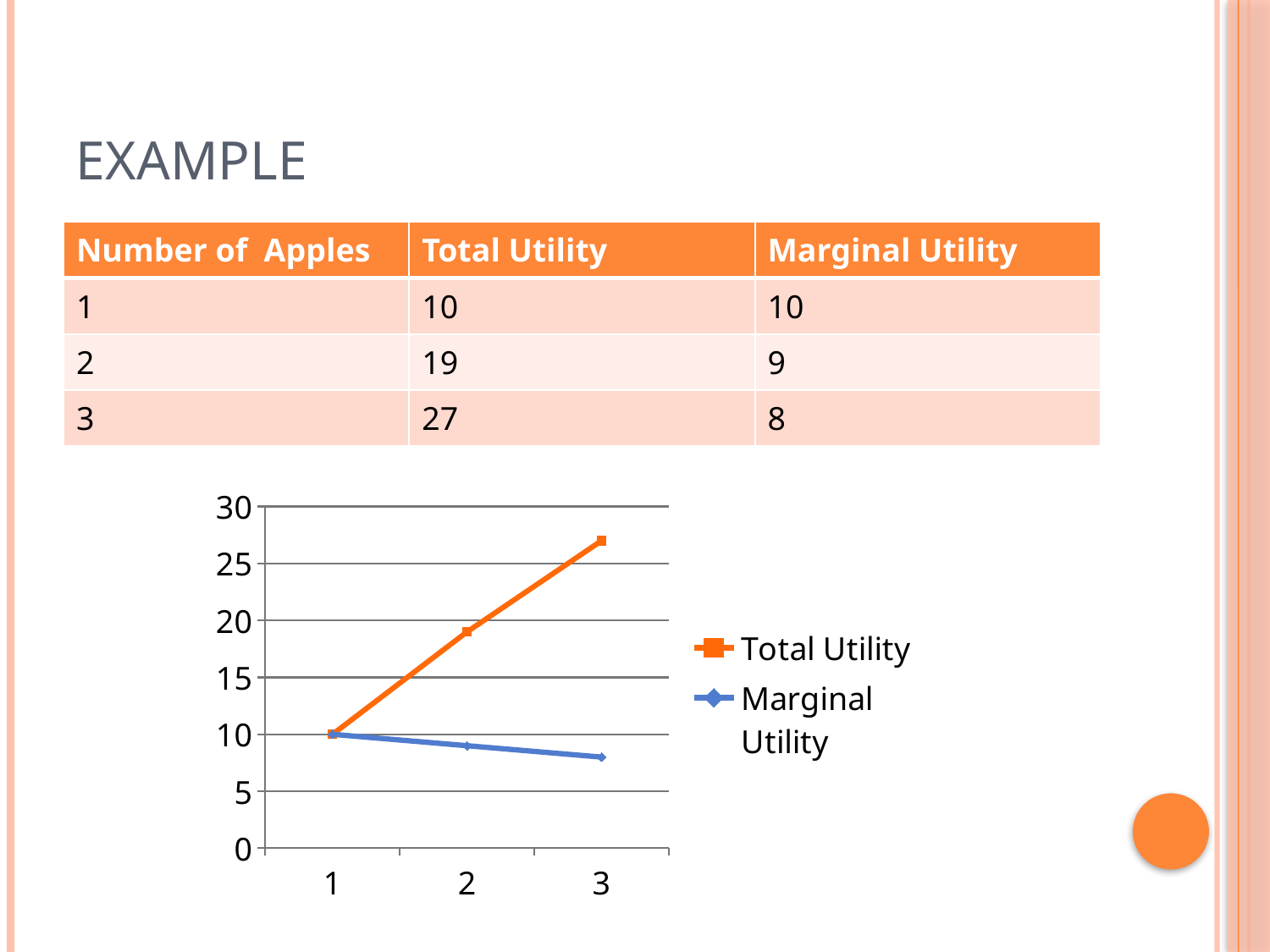
Does Total Utility rise or fall as the number of apples increases from 1 to 3? rise What is the difference between Total Utility and Marginal Utility at 3 apples? 19 What is the Total Utility value at 3 apples? 27 At 3 apples, which series has the larger value, Total Utility or Marginal Utility? Total Utility How many series does the chart legend list? 2 What kind of chart is shown on the slide? line chart Is the Marginal Utility value at 3 apples greater or less than 10? less Is the Total Utility value at 2 apples greater or less than 15? greater Does Marginal Utility rise or fall as the number of apples increases from 1 to 3? fall What is the Marginal Utility value at 1 apple? 10 How many points are plotted along the x axis for each series? 3 What is the Total Utility value at 1 apple? 10